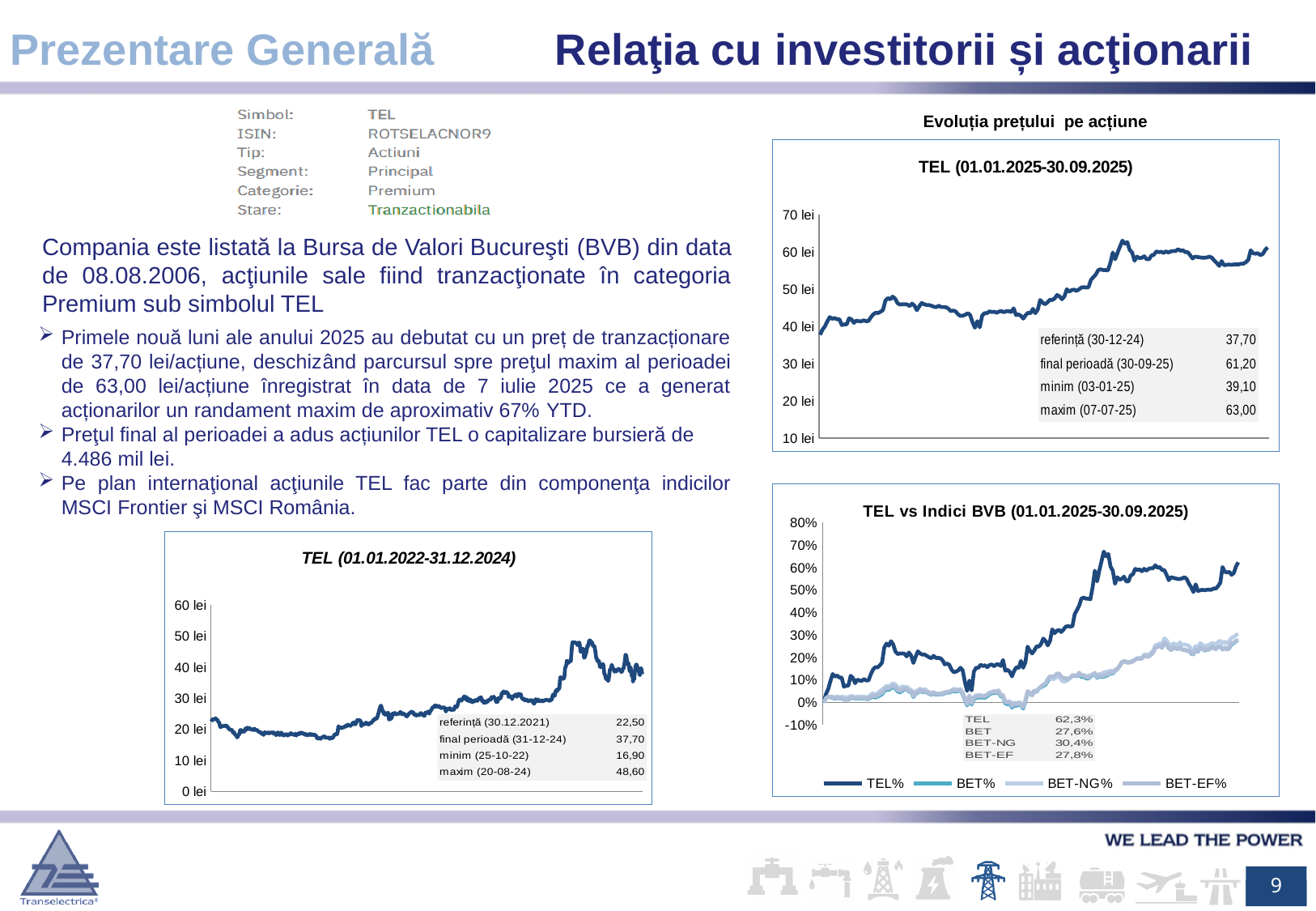
In the 'TEL (01.01.2022-31.12.2024)' chart, what is the maxim (20-08-24) value? 48,60 In the 'TEL (01.01.2025-30.09.2025)' chart, what is the maxim (07-07-25) value? 63,00 In the 'TEL (01.01.2022-31.12.2024)' chart, what is the difference between the final perioadă (31-12-24) value and the referință (30.12.2021) value? 15,20 In the 'TEL vs Indici BVB (01.01.2025-30.09.2025)' chart, which series has the highest value shown in the table? TEL In the 'TEL vs Indici BVB (01.01.2025-30.09.2025)' chart, which is larger, the BET-NG value or the BET-EF value? BET-NG In the 'TEL (01.01.2022-31.12.2024)' chart, what is the minim (25-10-22) value? 16,90 In the 'TEL (01.01.2025-30.09.2025)' chart, what is the difference between the maxim and the minim values? 23,90 In the 'TEL (01.01.2025-30.09.2025)' chart, what is the minim (03-01-25) value? 39,10 What kind of chart is the 'TEL (01.01.2025-30.09.2025)' chart? Line chart How many series does the legend of the 'TEL vs Indici BVB (01.01.2025-30.09.2025)' chart list? 4 In the 'TEL (01.01.2025-30.09.2025)' chart, does the price overall rise or fall from the start to the end of the period? Rise In the 'TEL (01.01.2025-30.09.2025)' chart, what is the final perioadă (30-09-25) value? 61,20